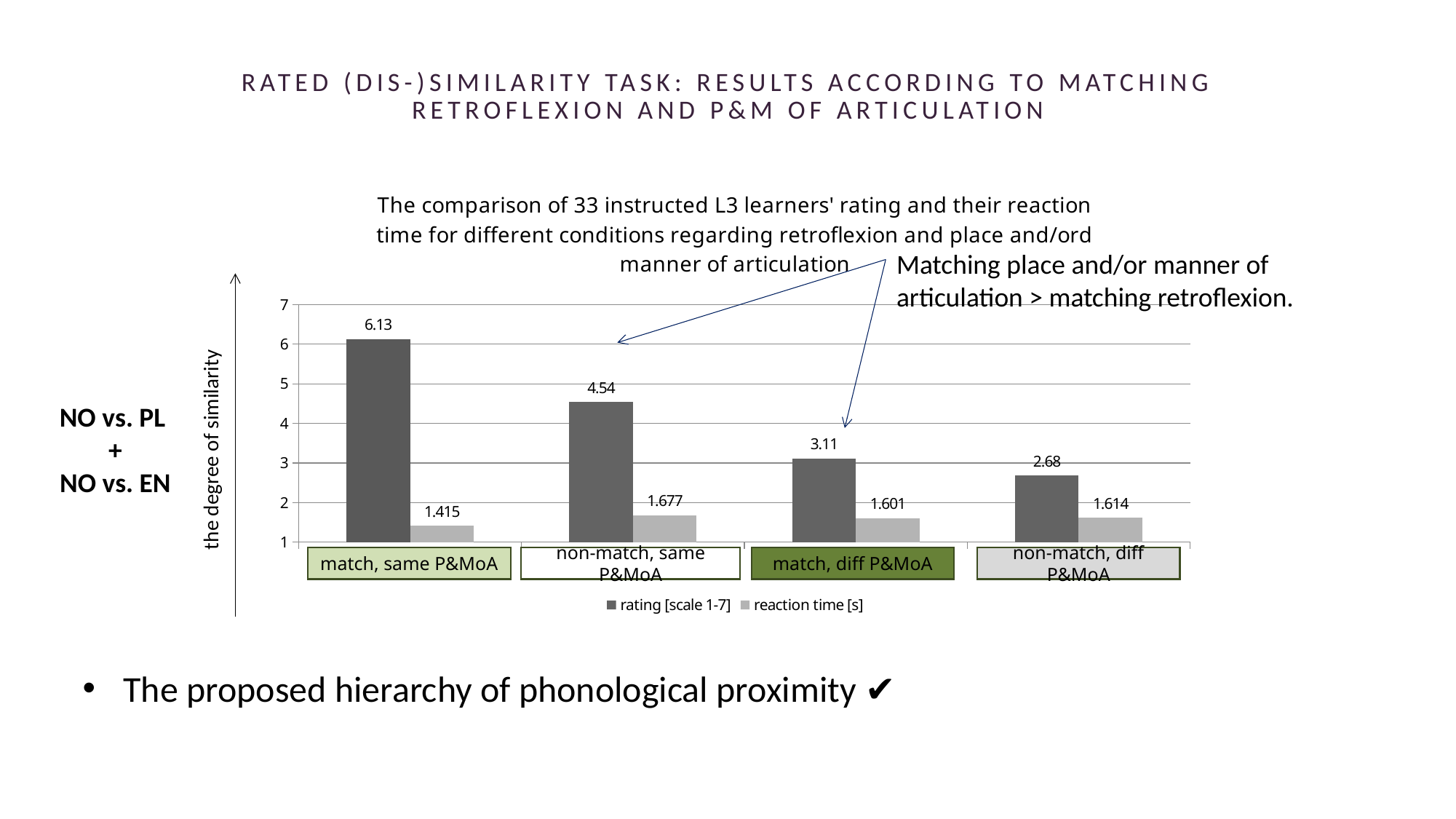
How many conditions (categories) are shown on the x axis of the chart? 4 What is the rating [scale 1-7] for the 'match, same P&MoA' condition? 6.13 Which is larger: the rating for 'match, diff P&MoA' or the rating for 'non-match, diff P&MoA'? match, diff P&MoA What is the rating [scale 1-7] for the 'non-match, diff P&MoA' condition? 2.68 Do the rating [scale 1-7] values rise or fall from left to right across the conditions? fall How many series does the chart legend list? 2 Which condition has the highest rating [scale 1-7]? match, same P&MoA Which condition has the lowest reaction time [s]? match, same P&MoA What is the reaction time [s] for the 'non-match, same P&MoA' condition? 1.677 What kind of chart is shown on the slide? bar chart What is the reaction time [s] for the 'match, diff P&MoA' condition? 1.601 What is the difference between the rating for 'match, same P&MoA' and the rating for 'non-match, same P&MoA'? 1.59